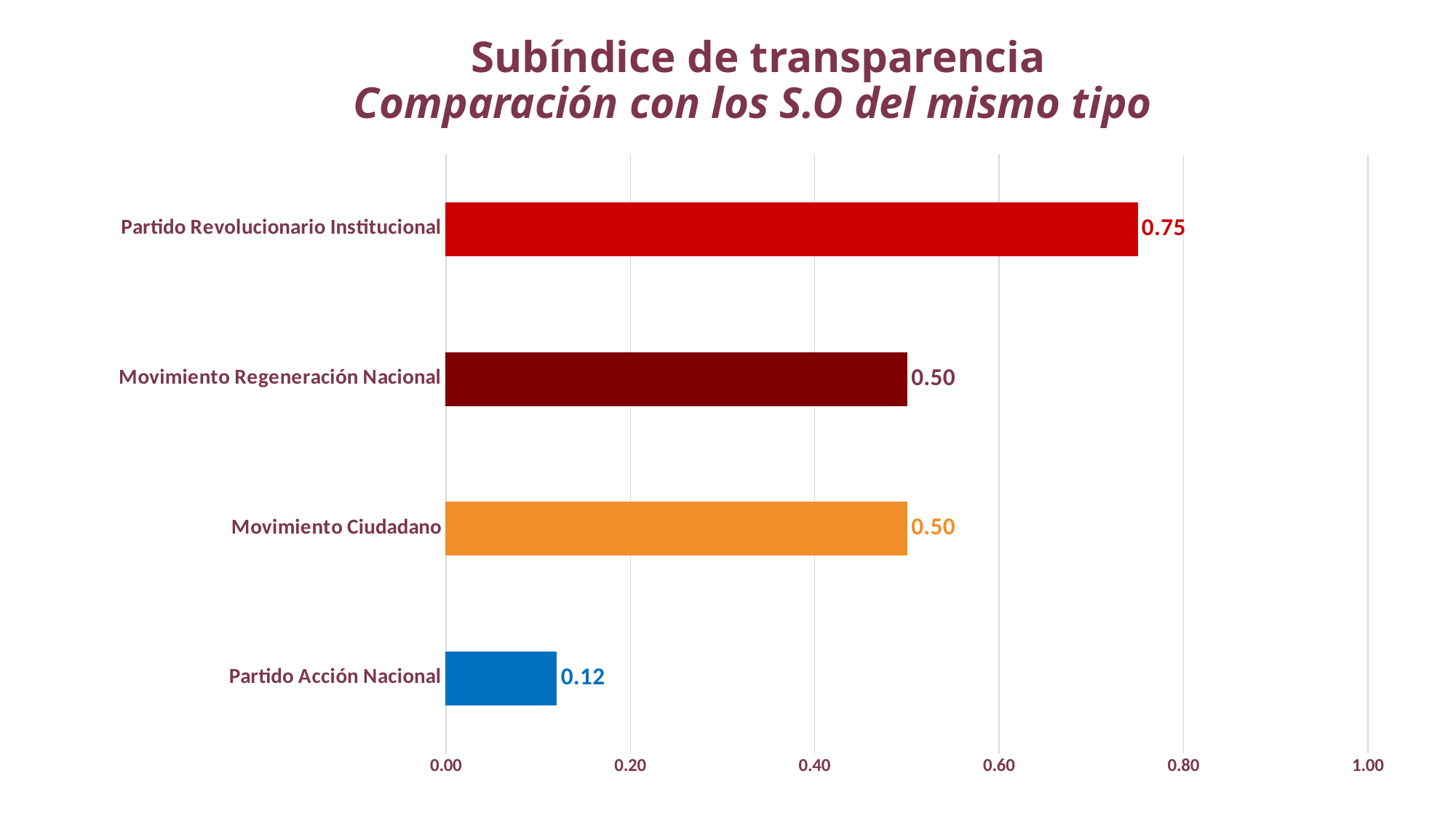
What is the difference between the values for Partido Revolucionario Institucional and Movimiento Ciudadano? 0.25 How many categories are shown in the chart? 4 Which category has the highest value? Partido Revolucionario Institucional What is the value for Movimiento Ciudadano? 0.50 What is the value for Partido Acción Nacional? 0.12 What kind of chart is shown on the slide? Bar chart What is the value for Partido Revolucionario Institucional? 0.75 What is the difference between the values for Partido Revolucionario Institucional and Partido Acción Nacional? 0.63 Which is larger, the value for Movimiento Regeneración Nacional or the value for Partido Acción Nacional? Movimiento Regeneración Nacional What is the value for Movimiento Regeneración Nacional? 0.50 What is the title of the chart? Subíndice de transparencia Which category has the lowest value? Partido Acción Nacional